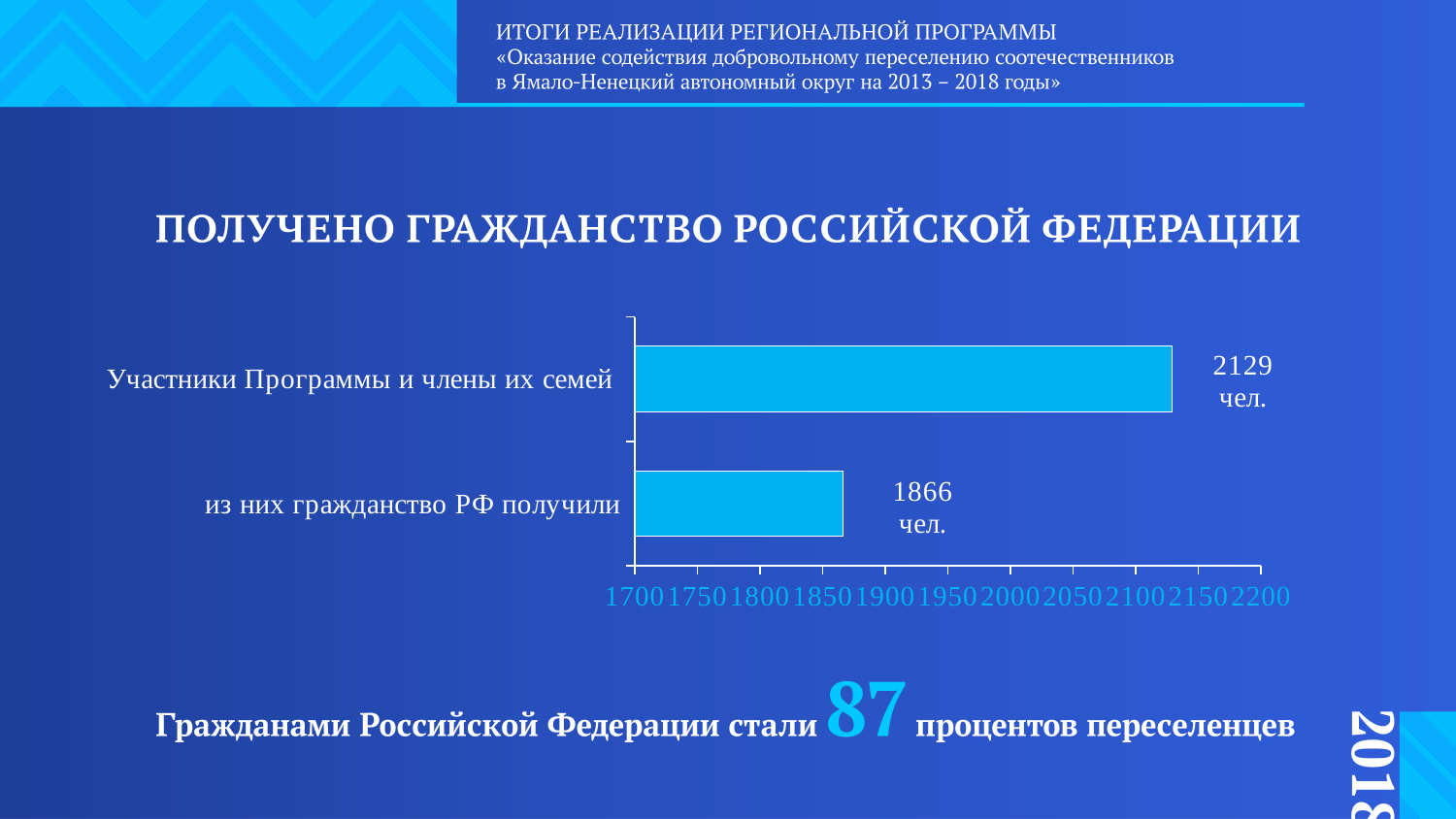
What is the highest tick value shown on the horizontal axis? 2200 How many categories are shown in the chart? 2 Is the value for «Участники Программы и члены их семей» greater or less than 2100? greater Which category has the highest value? Участники Программы и члены их семей What is the value for «из них гражданство РФ получили»? 1866 чел. Which category has the lowest value? из них гражданство РФ получили What kind of chart is shown on the slide? bar chart What is the title above the chart? ПОЛУЧЕНО ГРАЖДАНСТВО РОССИЙСКОЙ ФЕДЕРАЦИИ What is the value for «Участники Программы и члены их семей»? 2129 чел. Which is larger: the value for «Участники Программы и члены их семей» or the value for «из них гражданство РФ получили»? Участники Программы и члены их семей Is the value for «из них гражданство РФ получили» greater or less than 1900? less What is the difference between the value for «Участники Программы и члены их семей» and the value for «из них гражданство РФ получили»? 263 чел.